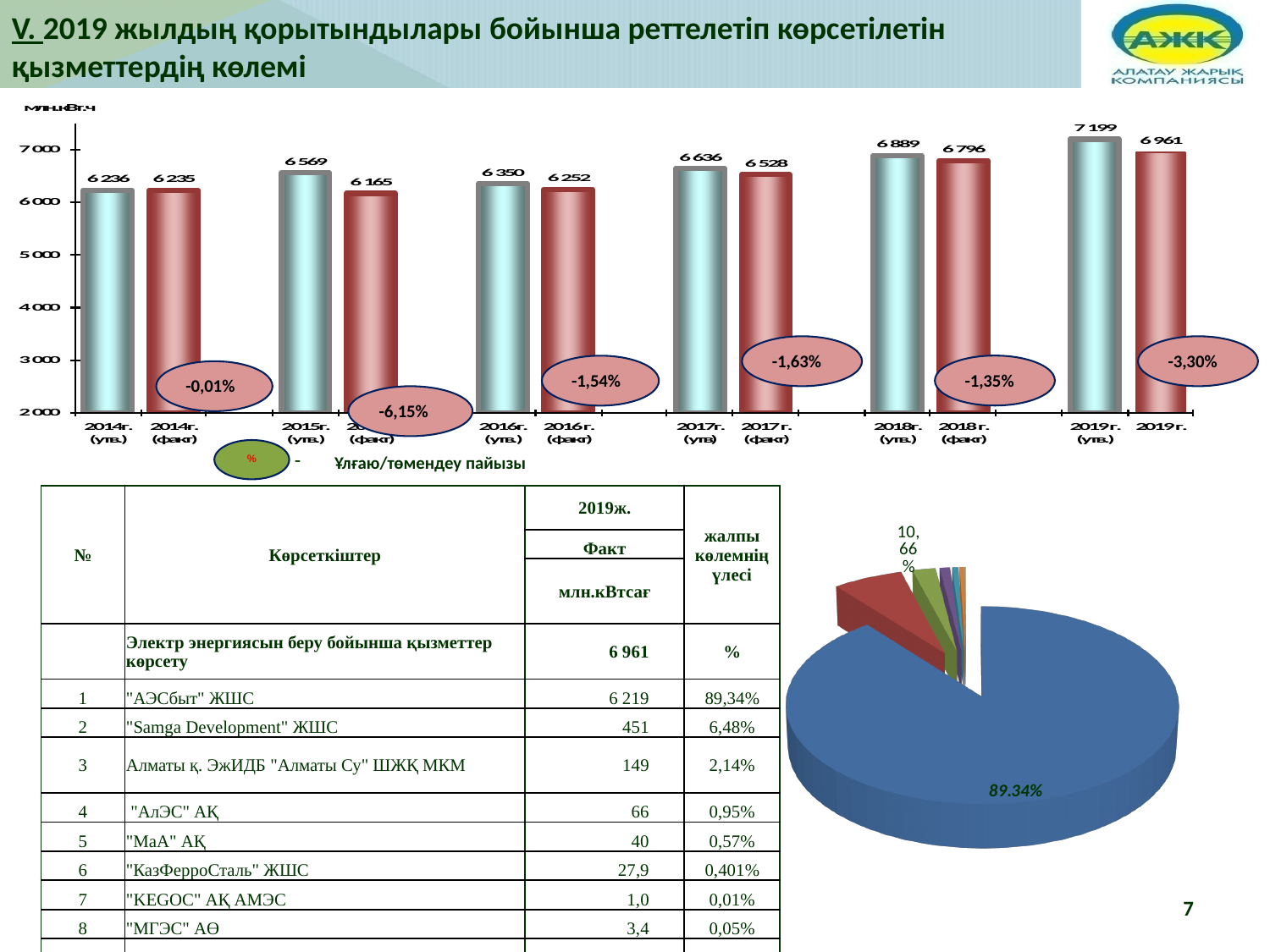
On the bar chart at the top of the slide, what percentage change is shown in the bubble for 2015 г.? -6,15% What kind of chart is shown at the top of the slide? bar chart On the bar chart at the top of the slide, which is larger: 2016 г. (утв.) or 2016 г. (факт)? 2016 г. (утв.) On the bar chart at the top of the slide, how many bars are plotted? 12 On the bar chart at the top of the slide, what is the value for 2015 г. (факт)? 6 165 On the bar chart at the top of the slide, which bar has the highest value? 2019 г. (утв.) On the bar chart at the top of the slide, what is the value for 2017 г. (факт)? 6 528 On the pie chart at the bottom right of the slide, what share is shown for the largest slice? 89.34% On the bar chart at the top of the slide, what is the difference between 2019 г. (утв.) and 2019 г. (факт)? 238 On the bar chart at the top of the slide, what is the difference between 2018 г. (утв.) and 2018 г. (факт)? 93 On the bar chart at the top of the slide, which bar has the lowest value? 2015 г. (факт) On the bar chart at the top of the slide, what is the value for 2019 г. (утв.)? 7 199